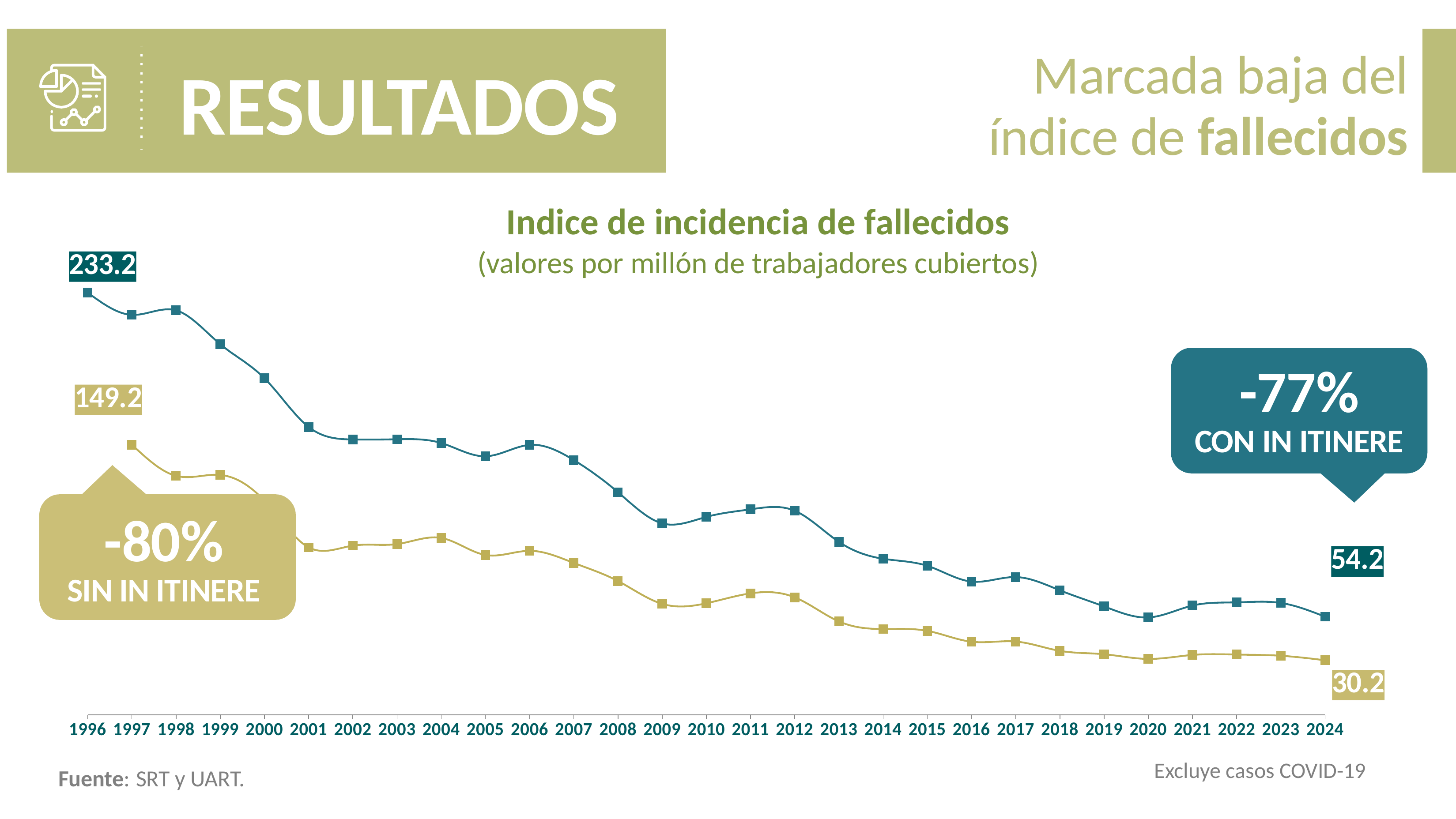
What is the first labelled value of the SIN IN ITINERE series? 149.2 What is the value of the CON IN ITINERE series in 1996? 233.2 In which year does the CON IN ITINERE series reach its highest value? 1996 Do the values of the CON IN ITINERE series generally rise or fall from 1996 to 2024? fall How many years are shown on the x axis? 29 What is the value of the CON IN ITINERE series in 2024? 54.2 In 2024, which series has the higher value, CON IN ITINERE or SIN IN ITINERE? CON IN ITINERE In 2024, what is the difference between the CON IN ITINERE and SIN IN ITINERE values? 24.0 What percentage change is shown in the callout for the CON IN ITINERE series? -77% What is the difference between the CON IN ITINERE values in 1996 and 2024? 179.0 What is the value of the SIN IN ITINERE series in 2024? 30.2 What kind of chart is shown on the slide? line chart